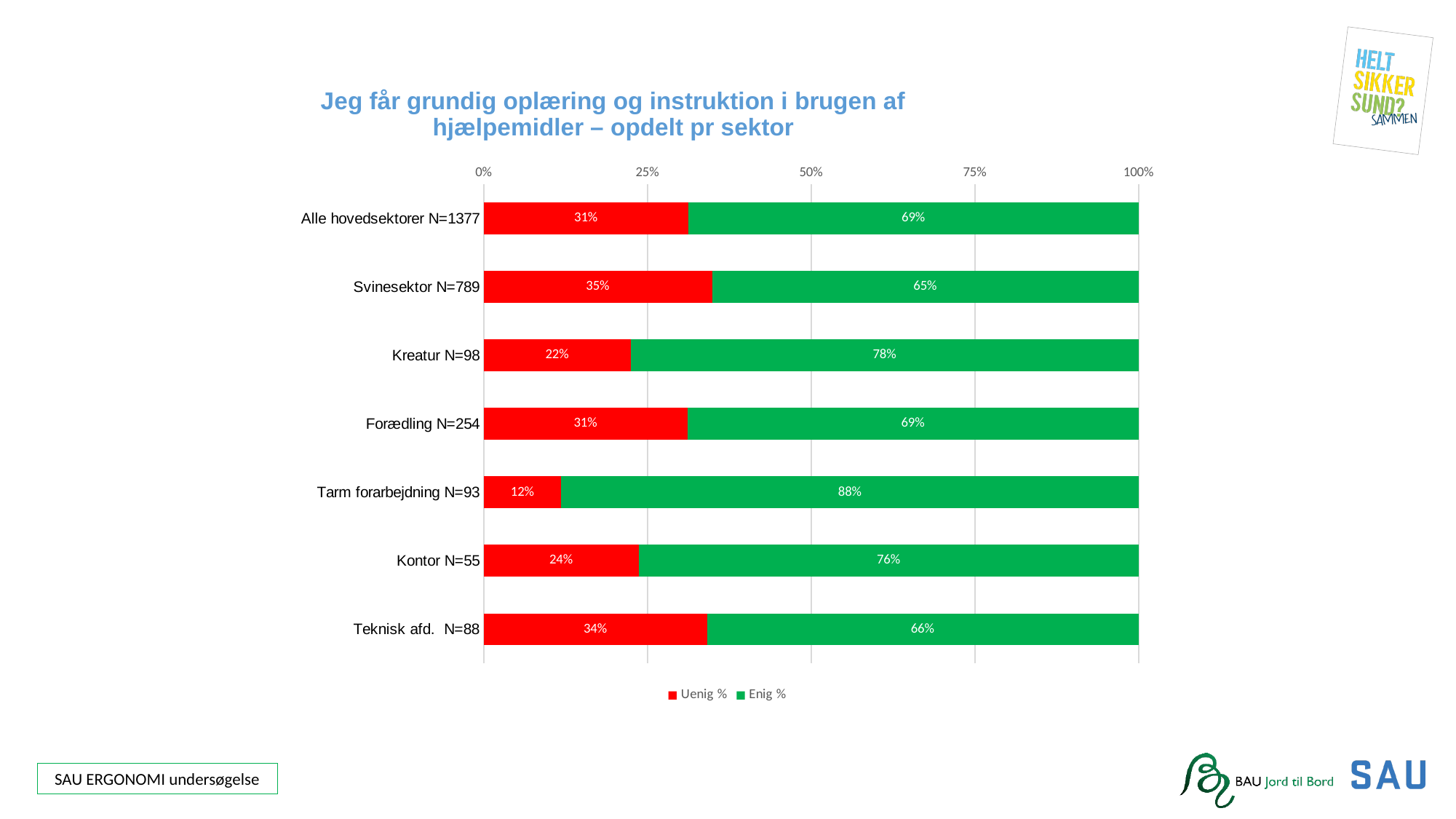
What is the Enig % value for Tarm forarbejdning N=93? 88% What kind of chart is shown on the slide? Stacked bar chart How many categories are shown on the chart? 7 What is the Enig % value for Kontor N=55? 76% Which category has the lowest Uenig % value? Tarm forarbejdning N=93 Which category has the highest Uenig % value? Svinesektor N=789 Which is larger: the Uenig % value for Kontor N=55 or for Kreatur N=98? Kontor N=55 Which category has the highest Enig % value? Tarm forarbejdning N=93 What is the Uenig % value for Svinesektor N=789? 35% How many series does the legend list? 2 What is the difference between the Enig % values for Kreatur N=98 and Teknisk afd. N=88? 12% What is the total of the stacked bar for Forædling N=254? 100%